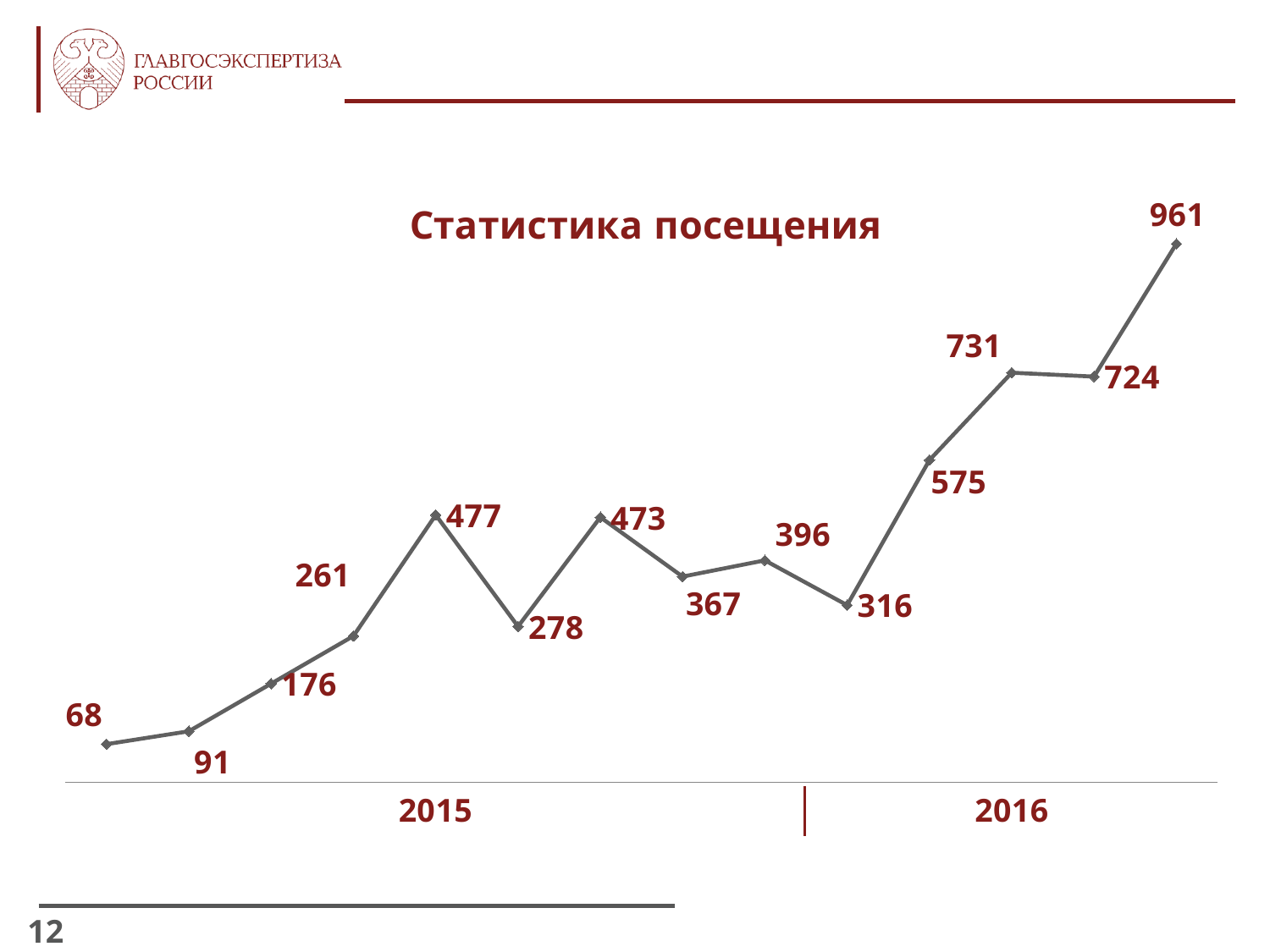
How many data points are plotted on the line? 14 What is the title of the chart? Статистика посещения What is the value of the last data point on the chart? 961 What is the difference between the highest and lowest values on the chart? 893 Do the values generally rise or fall from left to right along the x axis? rise What kind of chart is shown on the slide? line chart What is the value of the first data point on the chart? 68 How many data points fall in the 2016 section of the x axis? 5 Which is larger: the value labelled 575 or the value labelled 396? 575 What is the highest value plotted on the chart? 961 What is the lowest value plotted on the chart? 68 What is the difference between the values labelled 731 and 724? 7